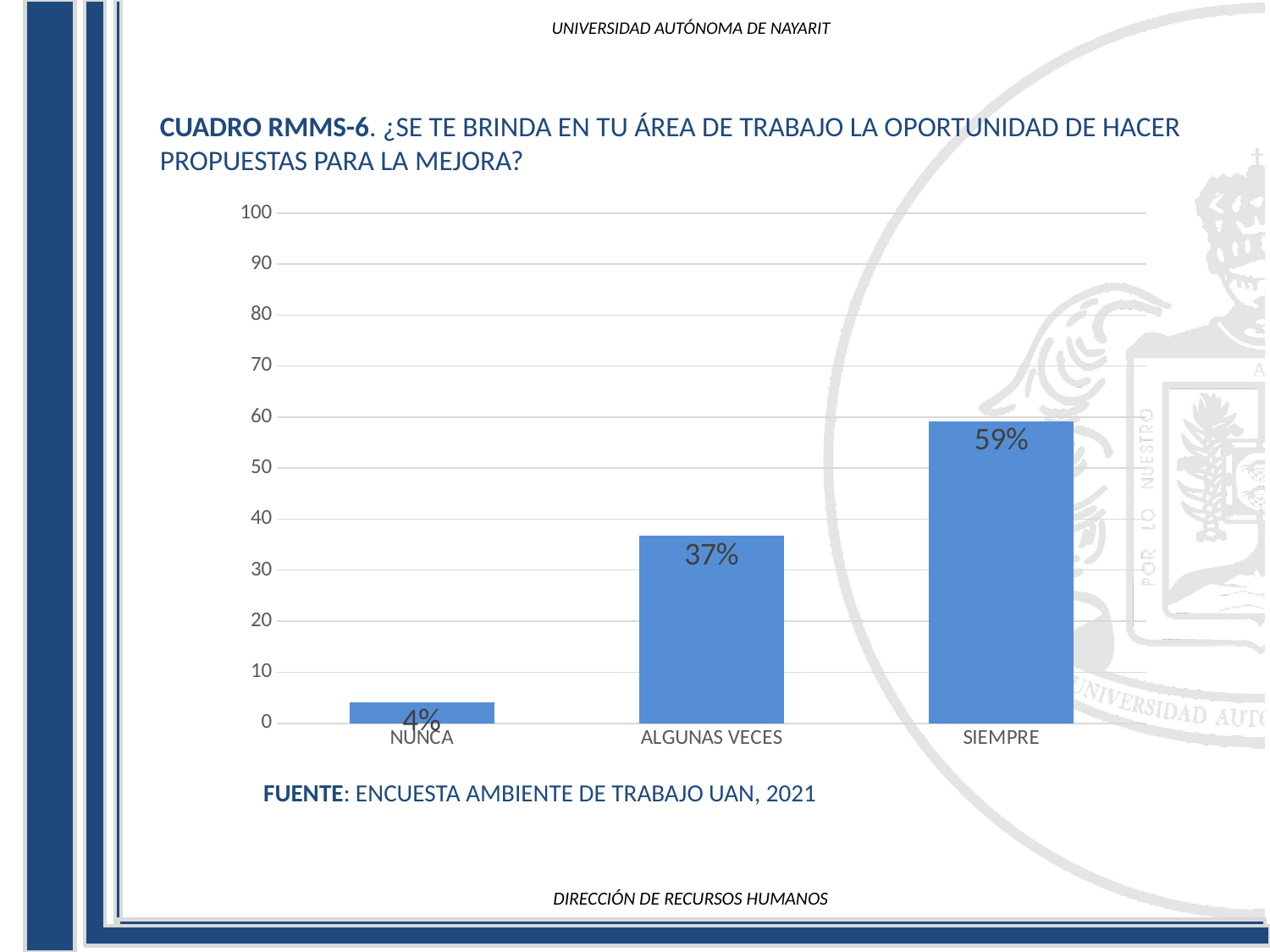
What is the value for NUNCA? 4% Which is larger, the value for ALGUNAS VECES or the value for NUNCA? ALGUNAS VECES What is the difference between the values for SIEMPRE and ALGUNAS VECES? 22% What is the value for SIEMPRE? 59% What is the value for ALGUNAS VECES? 37% Do the values rise or fall from left to right along the x axis? rise What kind of chart is shown on the slide? bar chart How many categories are shown on the x axis? 3 What is the difference between the values for ALGUNAS VECES and NUNCA? 33% Which category has the lowest value? NUNCA Which category has the highest value? SIEMPRE Is the value for SIEMPRE greater or less than 50? greater